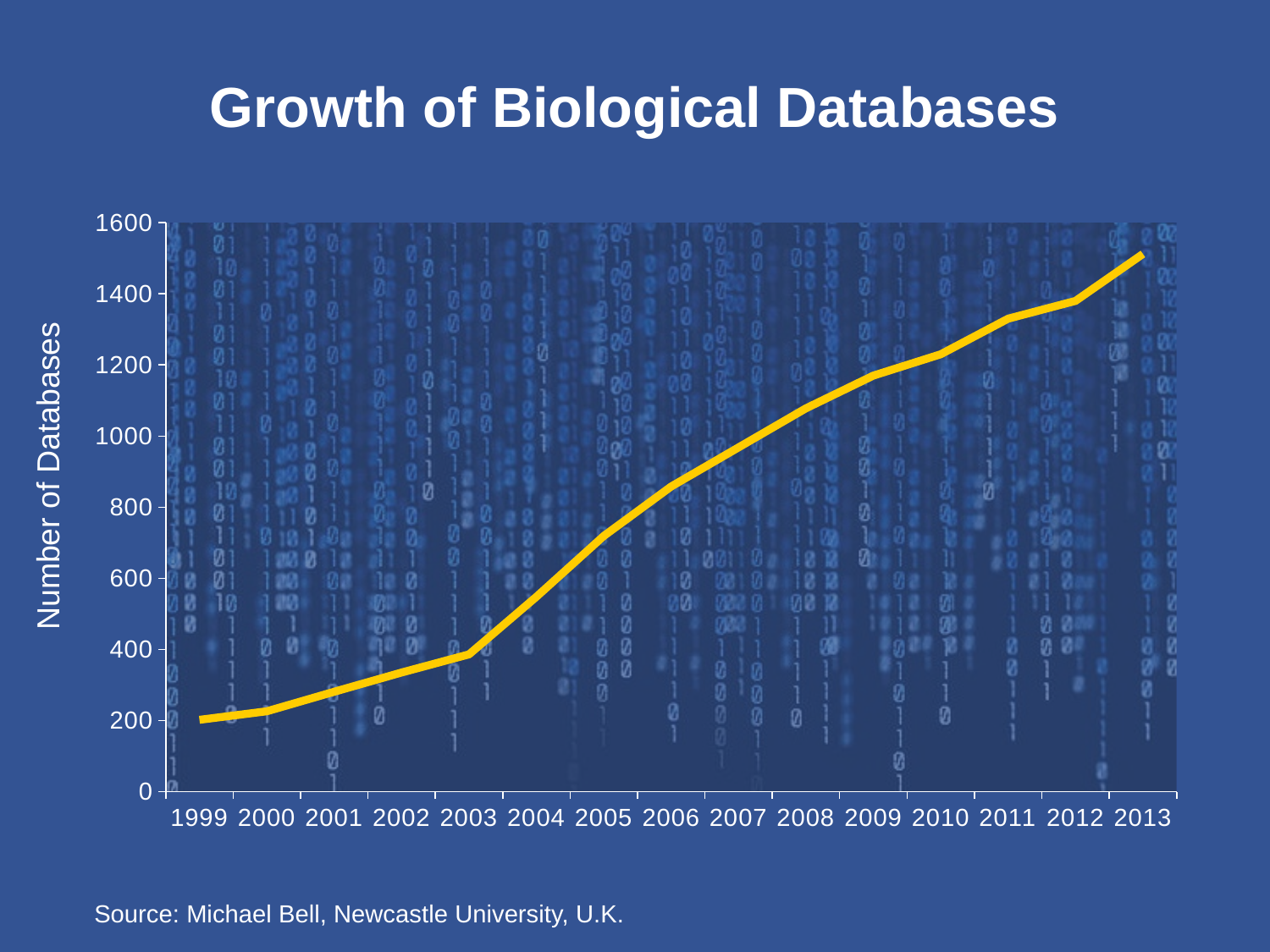
Do the values rise or fall from 1999 to 2013? rise What is the title of the chart? Growth of Biological Databases Is the value for 2007 greater or less than 800? greater Which is larger, the value for 2005 or the value for 2009? 2009 Which year has the lowest number of databases? 1999 Which year has the highest number of databases? 2013 Is the value for 2010 greater or less than 1400? less How many years are plotted along the x axis? 15 What is the label on the vertical axis? Number of Databases Is the value for 2013 greater or less than 1400? greater What kind of chart is shown on the slide? line chart